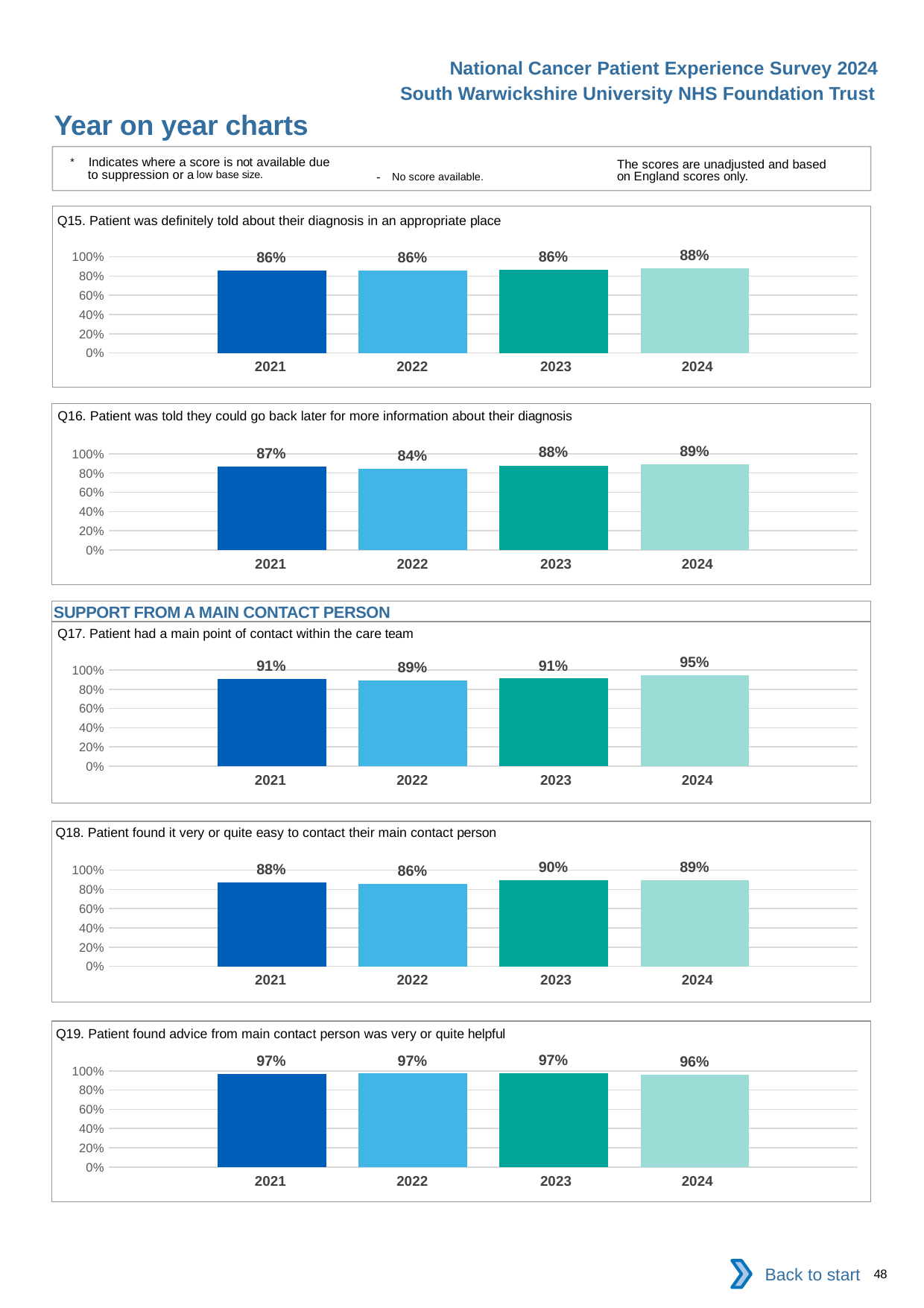
What kind of chart is the Q17 chart (Patient had a main point of contact within the care team)? Bar chart In the Q19 chart (Patient found advice from main contact person was very or quite helpful), which year has the lowest value? 2024 In the Q15 chart (Patient was definitely told about their diagnosis in an appropriate place), what is the value for 2024? 88% In the Q19 chart (Patient found advice from main contact person was very or quite helpful), what is the value for 2024? 96% In the Q16 chart (Patient was told they could go back later for more information about their diagnosis), which year has the lowest value? 2022 In the Q16 chart (Patient was told they could go back later for more information about their diagnosis), is the value for 2021 greater or less than 80%? greater In the Q18 chart (Patient found it very or quite easy to contact their main contact person), what is the value for 2023? 90% How many years (categories) are shown in the Q15 chart? 4 In the Q17 chart (Patient had a main point of contact within the care team), what is the difference between the 2024 and 2022 values? 6 percentage points In the Q17 chart (Patient had a main point of contact within the care team), which year has the highest value? 2024 In the Q16 chart (Patient was told they could go back later for more information about their diagnosis), what is the value for 2023? 88% In the Q18 chart (Patient found it very or quite easy to contact their main contact person), which is larger, the 2021 value or the 2022 value? 2021